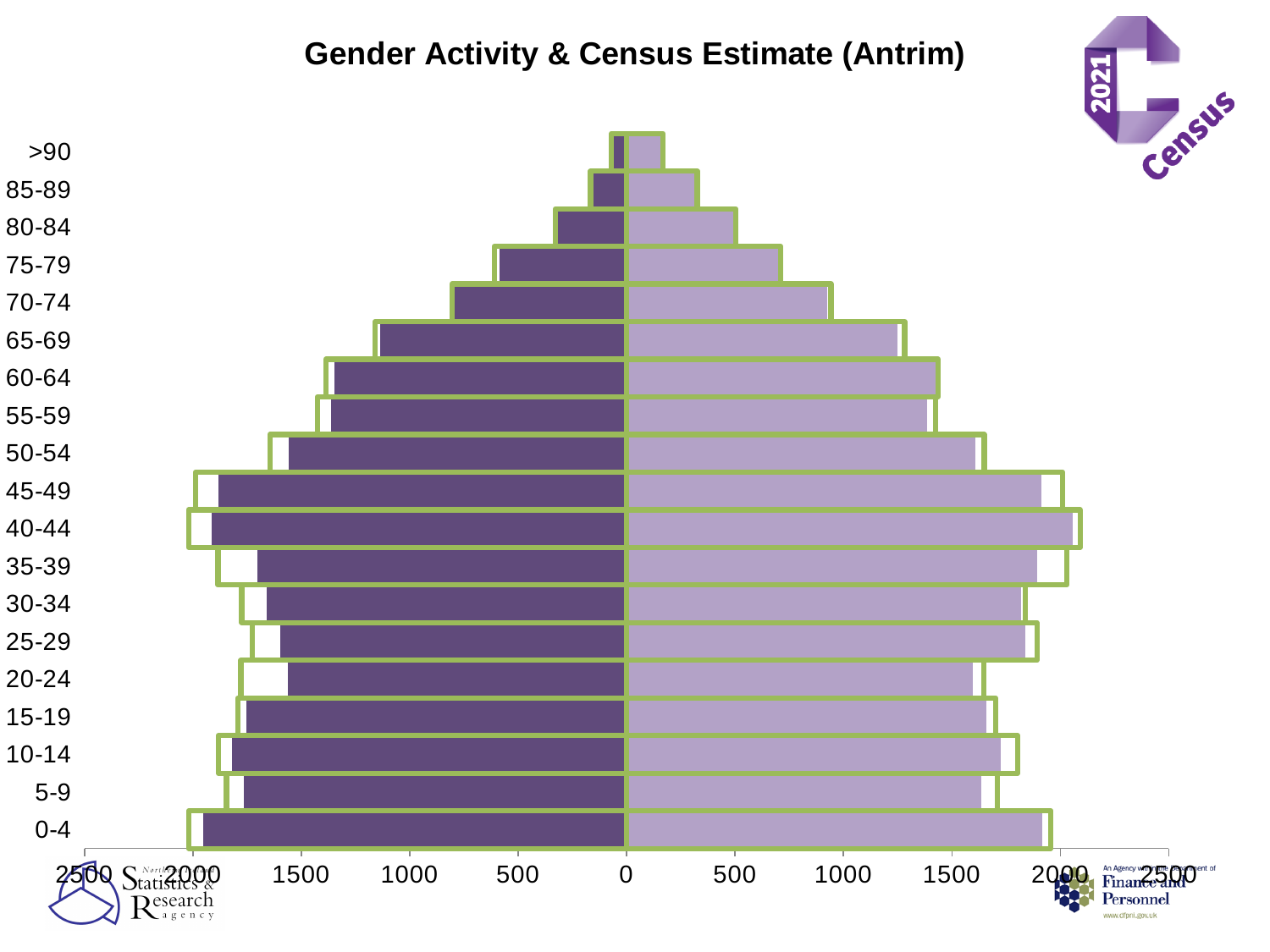
How many age-group categories are shown on the vertical axis? 19 Is the value of the dark purple bar for the 0-4 age group greater or less than 1500? greater Which age group has the shortest bars on the chart? >90 What is the title of the chart? Gender Activity & Census Estimate (Antrim) Is the value of the light purple bar for the 85-89 age group greater or less than 500? less Is the value of the dark purple bar for the >90 age group greater or less than 500? less What kind of chart is shown on the slide? Bar chart (population pyramid) Which age group has the longest bars on the chart? 40-44 Do the bar lengths generally rise or fall moving from the 40-44 age group up to the >90 age group? fall Which age group has the larger light purple bar, 40-44 or 75-79? 40-44